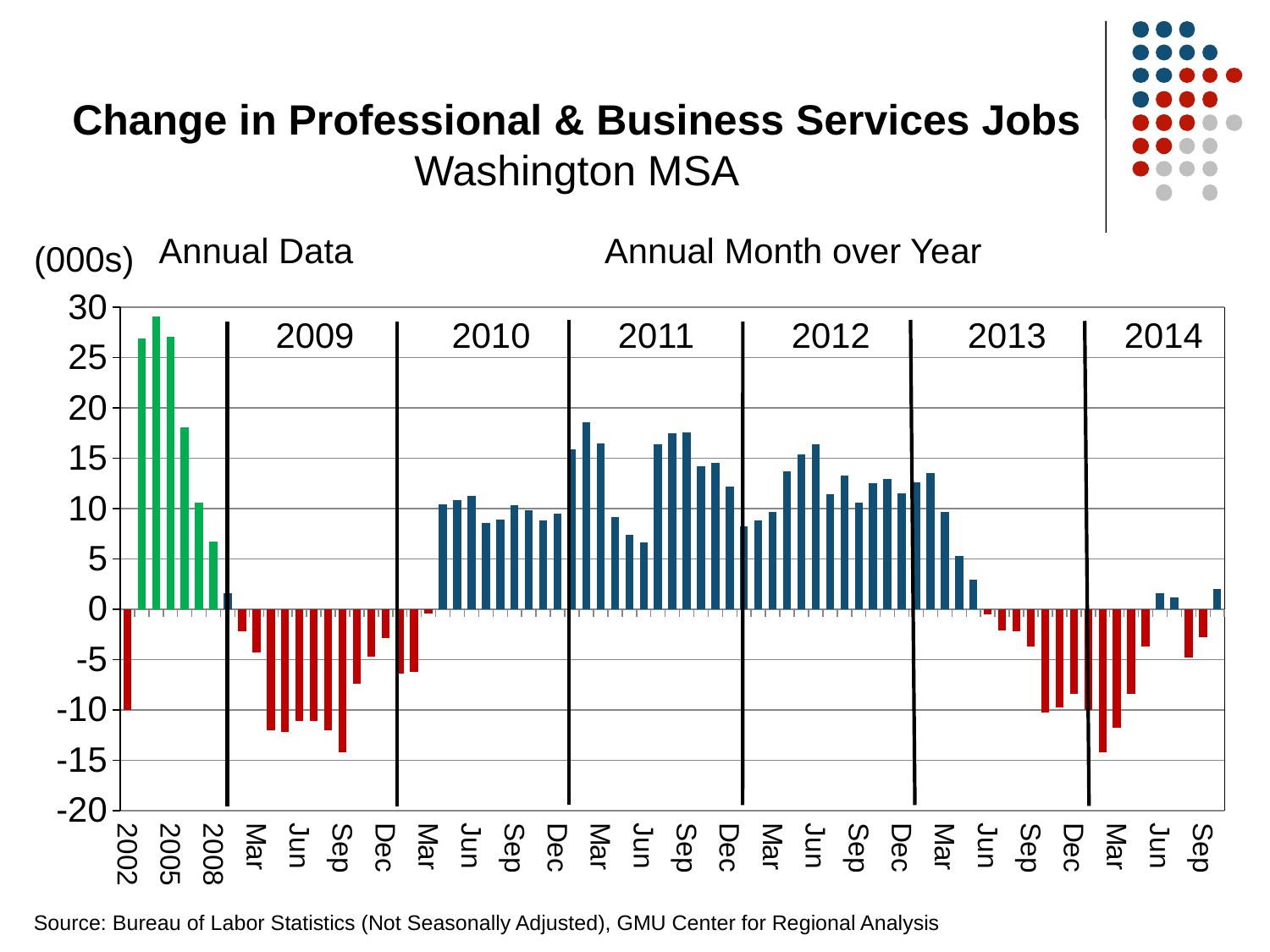
In the Annual Data section, which year has the highest value? 2004 In what units are the values on the y axis expressed? (000s) What kind of chart is shown on the slide? bar chart Is the annual value for 2004 greater or less than 25? greater Is the month-over-year value for Mar 2011 greater or less than 15? greater Is the annual value for 2002 greater or less than -5? less How many years are labeled in the Annual Month over Year section of the chart? 6 In the Annual Data section, which year has the lowest value? 2002 Which is larger, the annual value for 2003 or the annual value for 2008? 2003 What is the title of the chart? Change in Professional & Business Services Jobs, Washington MSA Do the annual values rise or fall from 2004 to 2008? fall